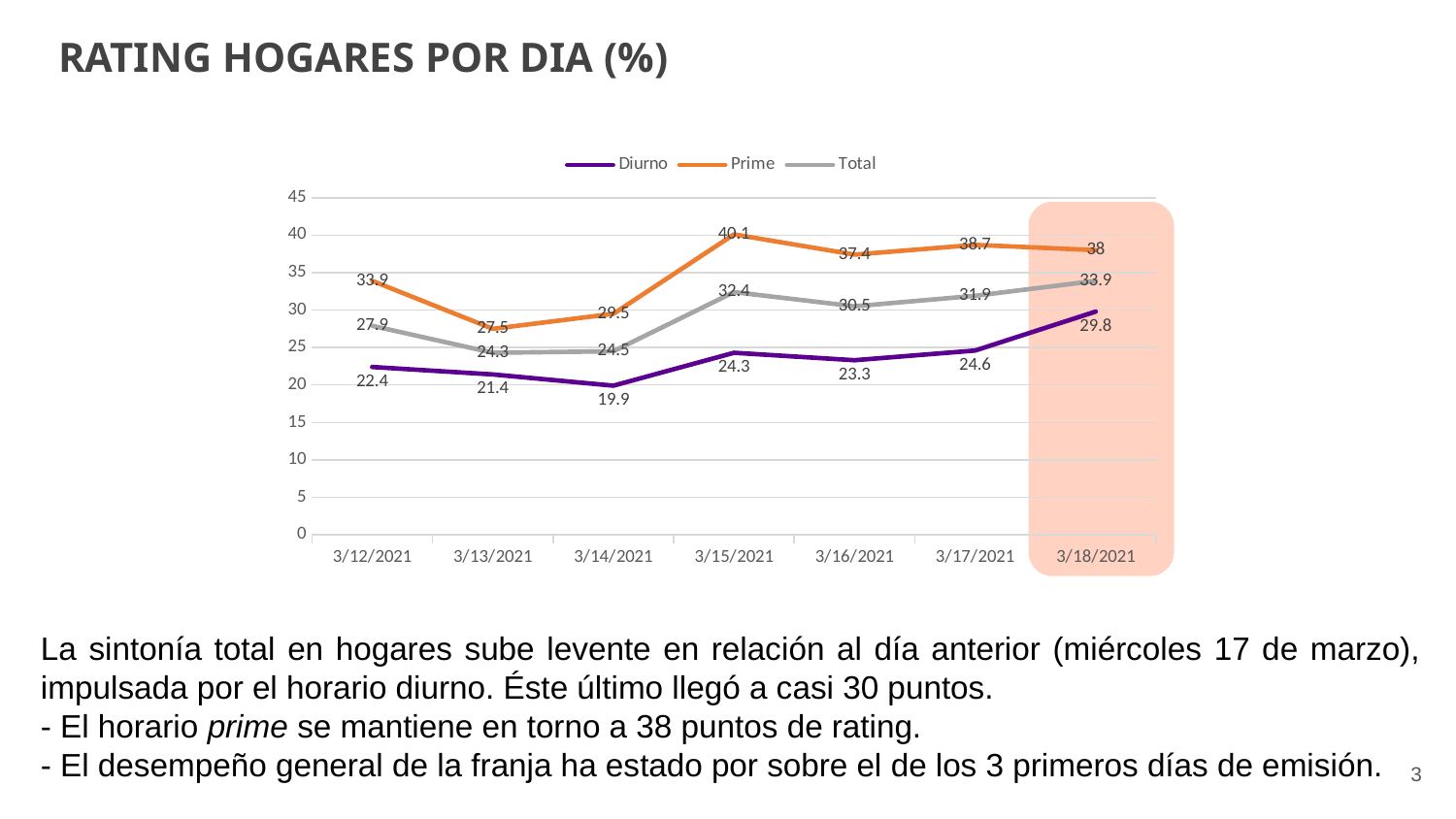
On which date is the Prime series highest? 3/15/2021 What is the difference between the Prime and Diurno values on 3/18/2021? 8.2 What is the title of the chart on the slide? RATING HOGARES POR DIA (%) What is the Prime value on 3/15/2021? 40.1 Which is larger, the Total value on 3/12/2021 or the Total value on 3/16/2021? 3/16/2021 What is the Total value on 3/13/2021? 24.3 What is the Diurno value on 3/18/2021? 29.8 How many series does the legend list? 3 How many dates are plotted along the x axis? 7 Does the Diurno series rise or fall from 3/17/2021 to 3/18/2021? rise On which date is the Diurno series lowest? 3/14/2021 What type of chart is shown on the slide? line chart